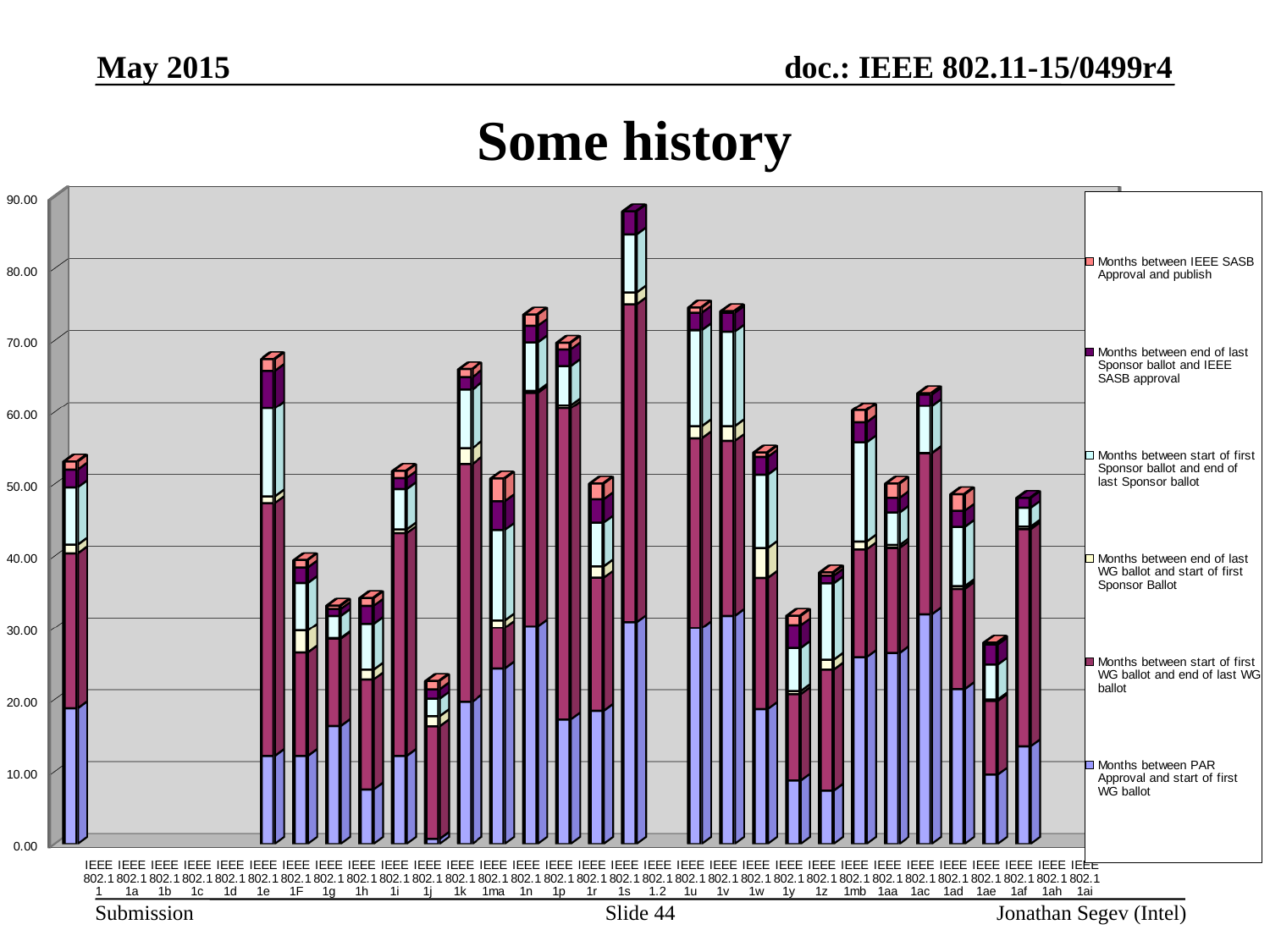
How many series does the legend list? 6 Is the total stacked value for IEEE 802.1n greater or less than 70.00? greater Is the total stacked value for IEEE 802.1y greater or less than 40.00? less What is the title of the chart? Some history Which category has the tallest stacked bar? IEEE 802.11s Is the total stacked value for IEEE 802.1e greater or less than 60.00? greater What kind of chart is shown on the slide? stacked bar chart Which has the taller stacked bar, IEEE 802.1ac or IEEE 802.1ad? IEEE 802.1ac Which has the taller stacked bar, IEEE 802.1j or IEEE 802.1k? IEEE 802.1k Which series is shown at the bottom of each stacked bar, according to the legend? Months between PAR Approval and start of first WG ballot